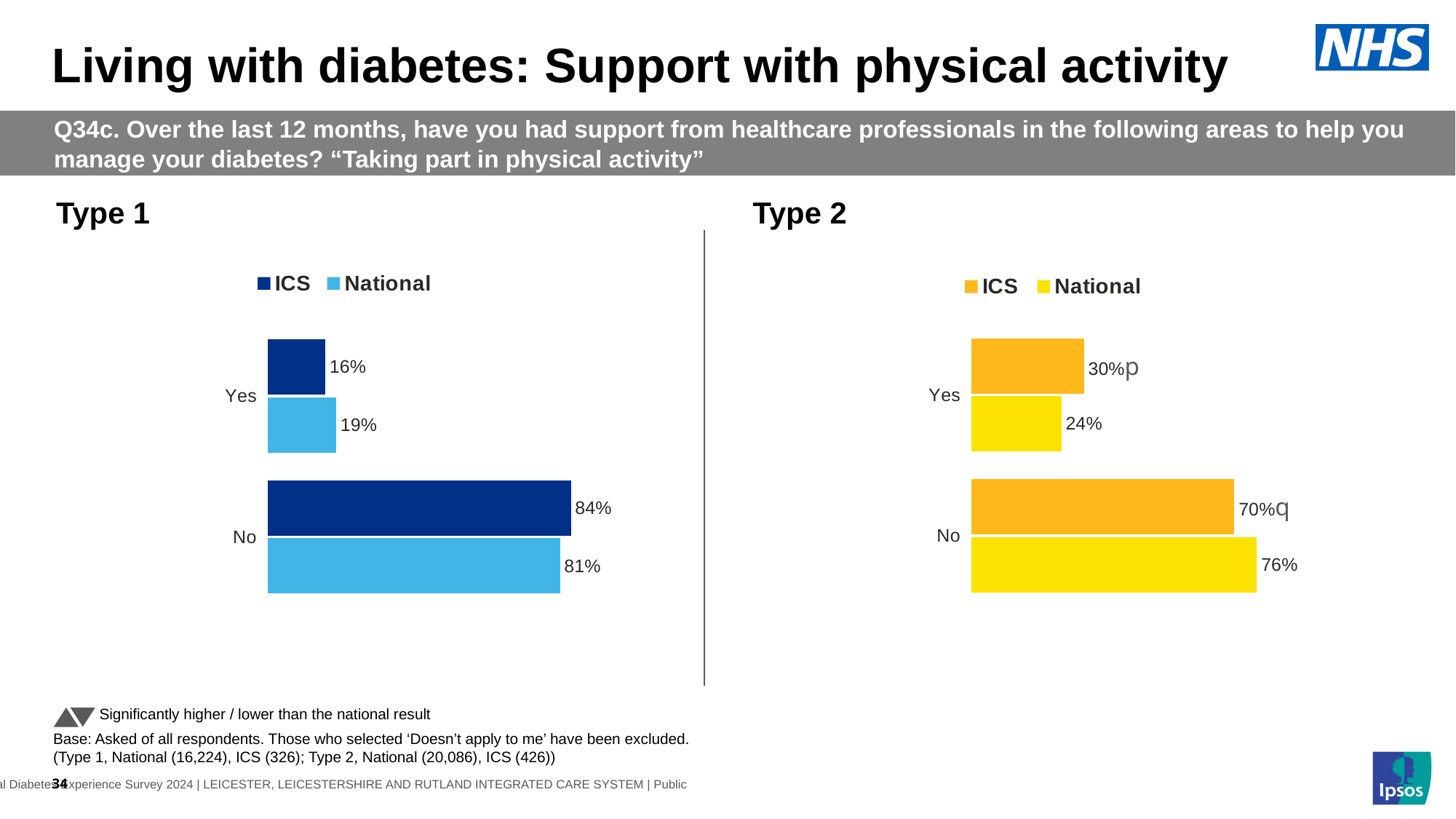
In the Type 2 chart, what is the ICS value for Yes? 30% How many categories are shown in the Type 2 chart? 2 In the Type 2 chart, what is the difference between the ICS and National values for Yes? 6 percentage points In the Type 1 chart, what is the difference between the ICS and National values for No? 3 percentage points In the Type 1 chart, which category has the highest ICS value? No What kind of chart is the Type 1 chart? Bar chart In the Type 1 chart, what is the National value for No? 81% How many series does the legend of the Type 2 chart list? 2 In the Type 2 chart, what is the National value for No? 76% In the Type 2 chart, which is larger for No: ICS or National? National In the Type 1 chart, which is larger for Yes: ICS or National? National In the Type 1 chart, what is the ICS value for Yes? 16%